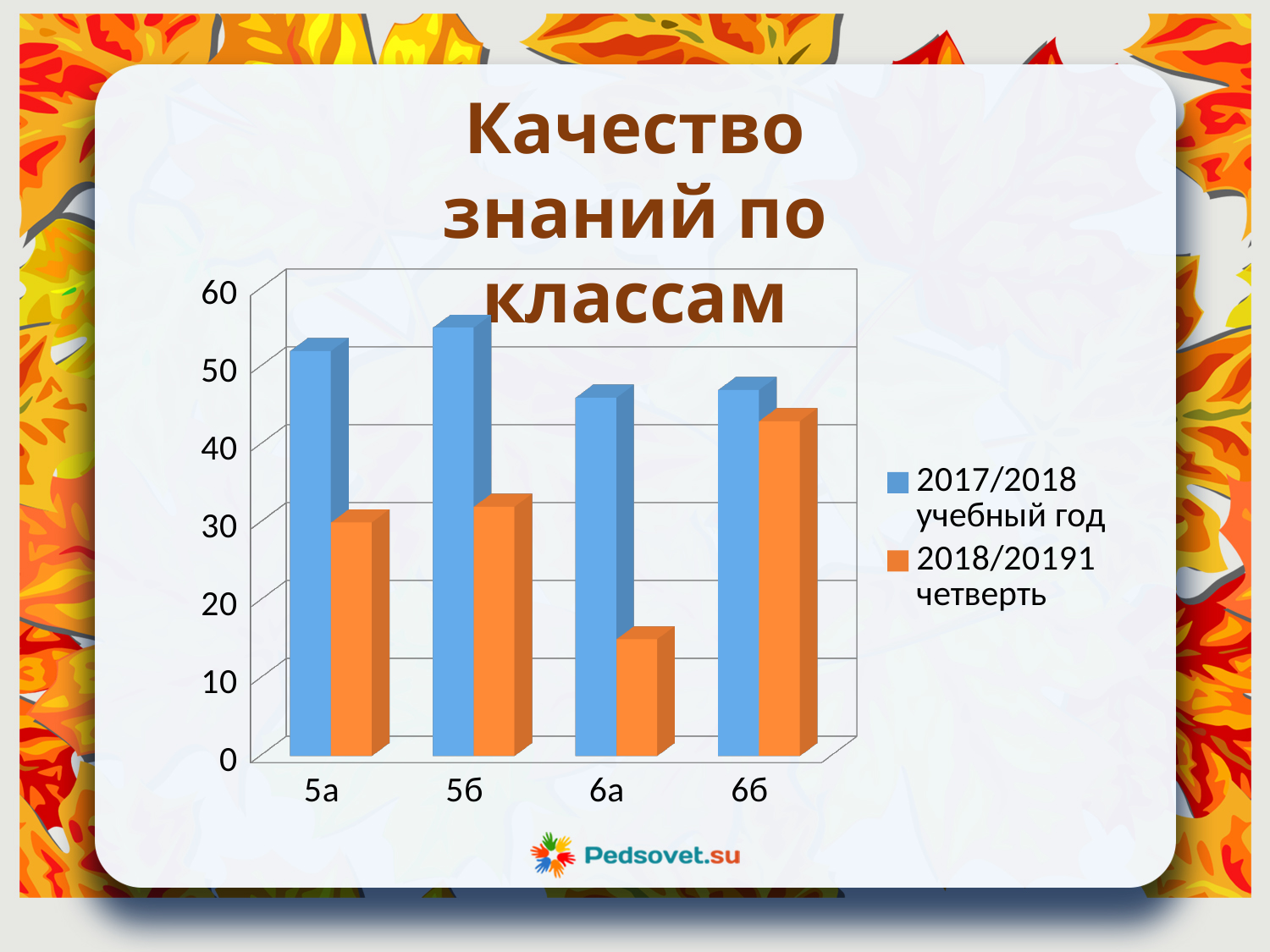
Is the value for 6а in the "2017/2018 учебный год" series greater or less than 50? less Which colour represents the series "2018/20191 четверть"? orange For class 5а, which series has the larger value: "2017/2018 учебный год" or "2018/20191 четверть"? 2017/2018 учебный год Which class has the lowest value for the "2018/20191 четверть" series? 6а What type of chart is shown on the slide? bar chart Which class has the highest value for the "2017/2018 учебный год" series? 5б Which class has the highest value for the "2018/20191 четверть" series? 6б Is the value for 5б in the "2017/2018 учебный год" series greater or less than 50? greater How many classes (categories) are shown on the x axis? 4 What is the title of the chart? Качество знаний по классам How many series does the legend list? 2 Is the value for 6а in the "2018/20191 четверть" series greater or less than 20? less